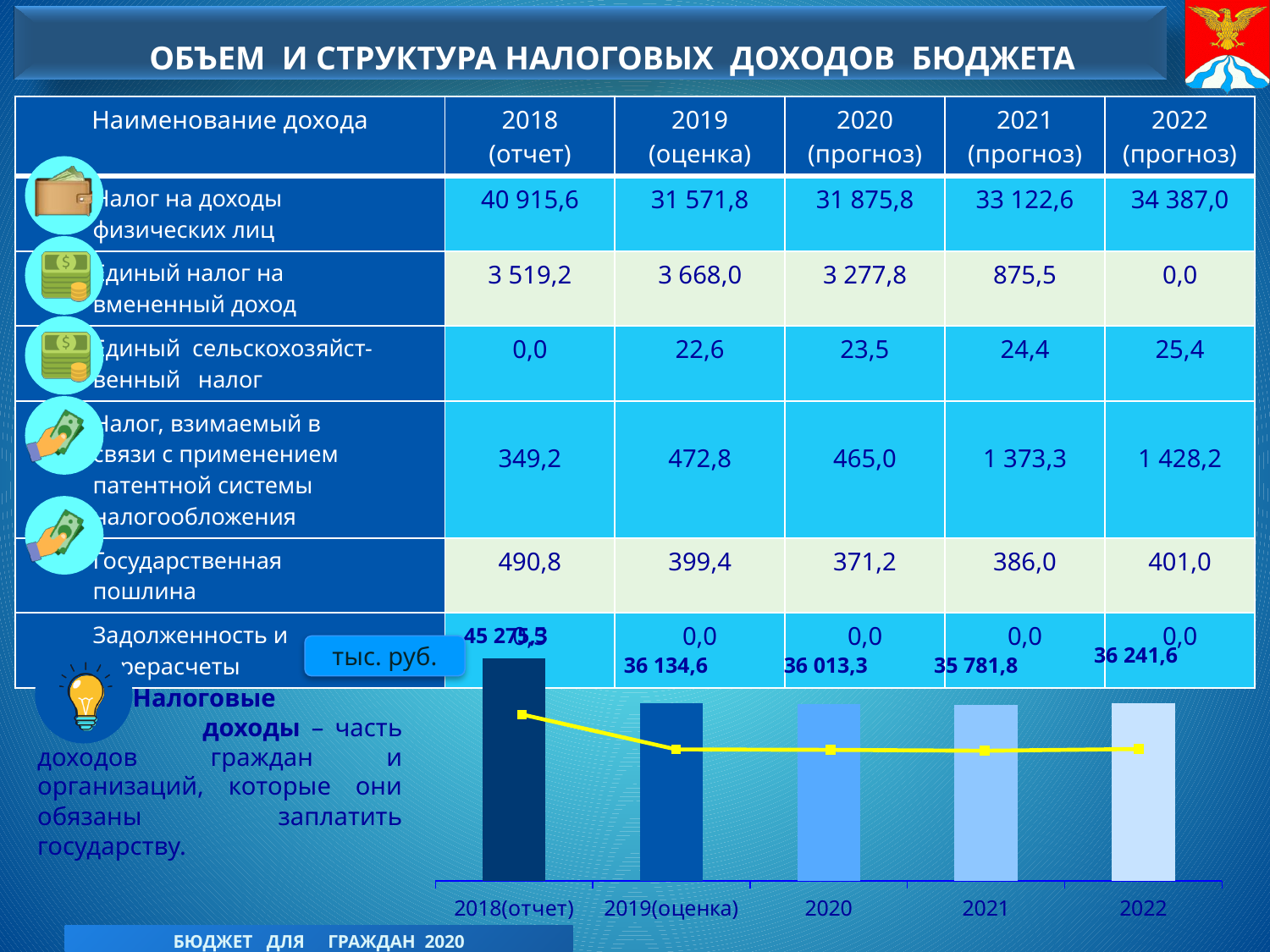
What kind of chart is shown at the bottom of the slide? bar chart with a line overlay What is the value labelled for 2019(оценка) in the chart? 36 134,6 What unit is indicated for the values in the chart? тыс. руб. What is the value labelled for 2020 in the chart? 36 013,3 What is the difference between the values for 2019(оценка) and 2020 in the chart? 121,3 Which year has the lowest labelled value in the chart? 2021 What is the value labelled for 2021 in the chart? 35 781,8 How many years (categories) are shown on the x axis of the chart? 5 What is the difference between the values for 2022 and 2021 in the chart? 459,8 Which is larger in the chart, the value for 2019(оценка) or the value for 2021? 2019(оценка) Which year has the tallest bar in the chart? 2018(отчет) What is the value labelled for 2022 in the chart? 36 241,6